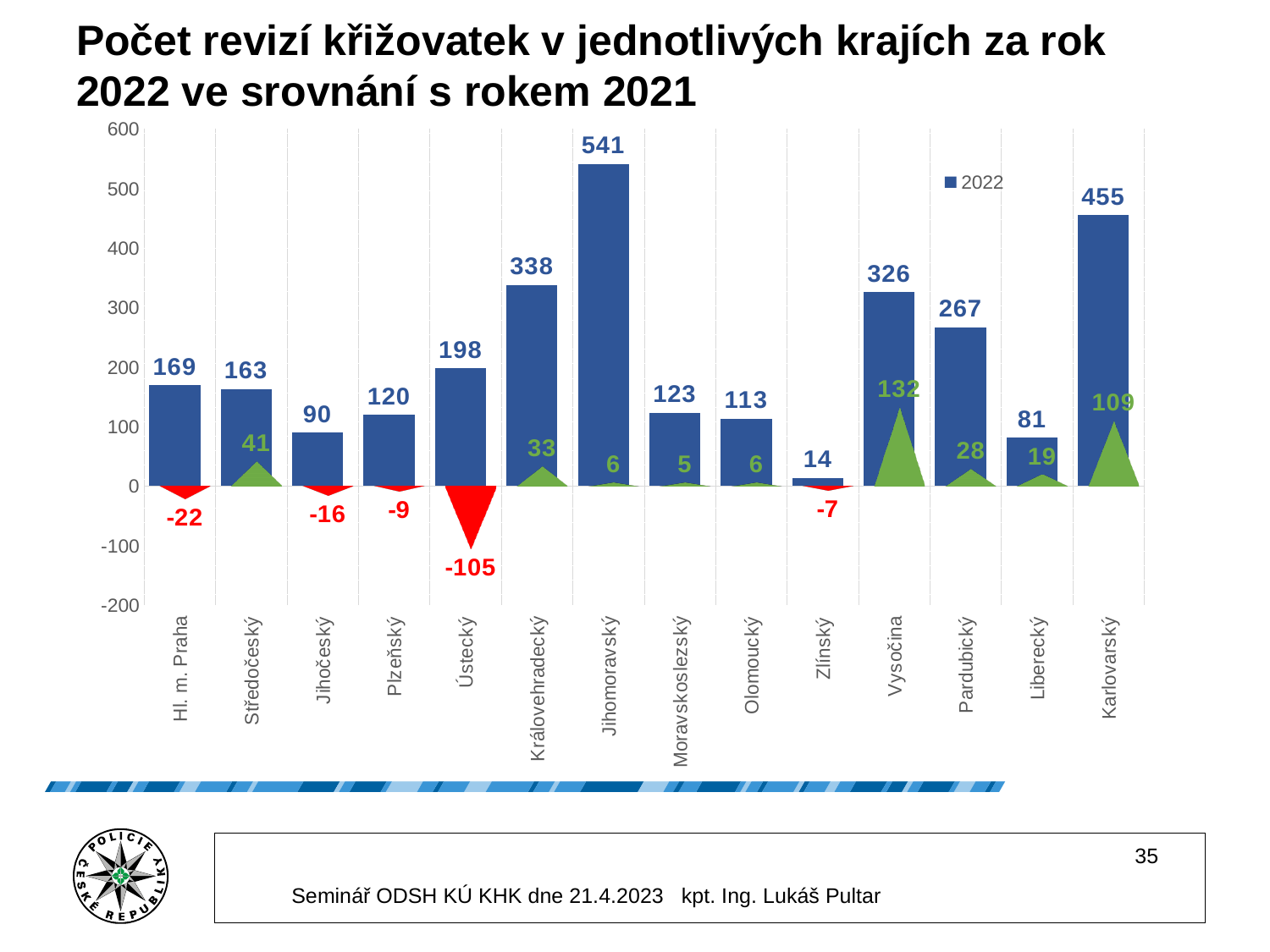
What series name is listed in the legend? 2022 What is the 2022 value for Jihomoravský? 541 Which region has the lowest 2022 value? Zlínský What is the 2022 value for Liberecký? 81 What is the difference between the 2022 values for Karlovarský and Pardubický? 188 How many regions are shown on the x axis? 14 What change value is shown for Vysočina? 132 What change value is shown for Ústecký? -105 Which has a larger 2022 value, Královehradecký or Vysočina? Královehradecký What kind of chart is shown on the slide? Bar chart What is the 2022 value for Vysočina? 326 Which region has the highest 2022 value? Jihomoravský